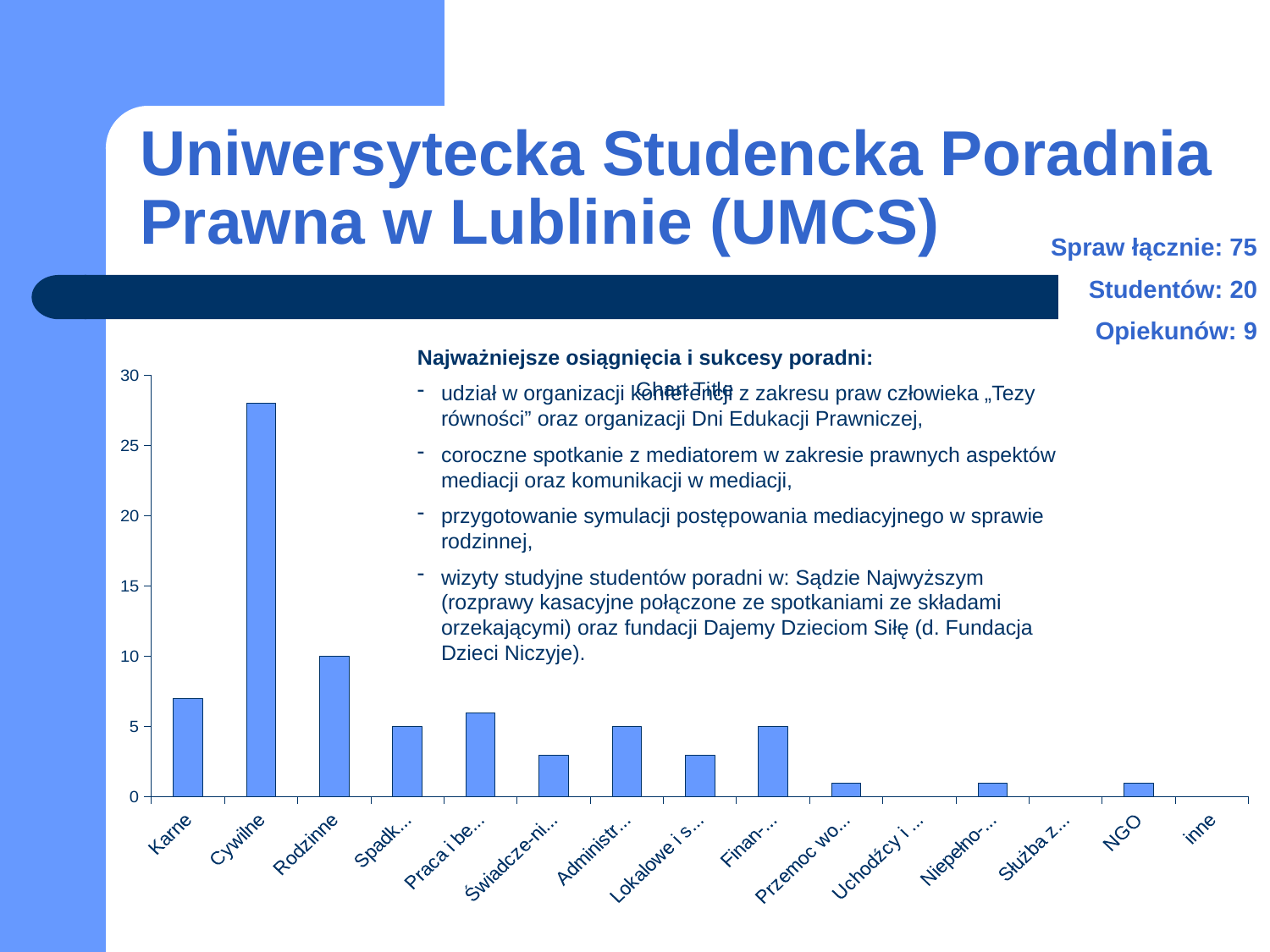
Is the value for NGO greater or less than 5? less Is the value for Karne greater or less than 5? greater How many categories are shown on the x axis of the chart? 15 What is the value for Rodzinne in the chart? 10 Which category has the highest bar in the chart? Cywilne Is the value for Cywilne greater or less than 25? greater Which is larger, the value for Karne or the value for Rodzinne? Rodzinne What is the value for the category labelled "Administr..." in the chart? 5 What title is printed above the chart? Chart Title Which is larger, the value for Cywilne or the value for Karne? Cywilne What kind of chart is shown on the slide? bar chart